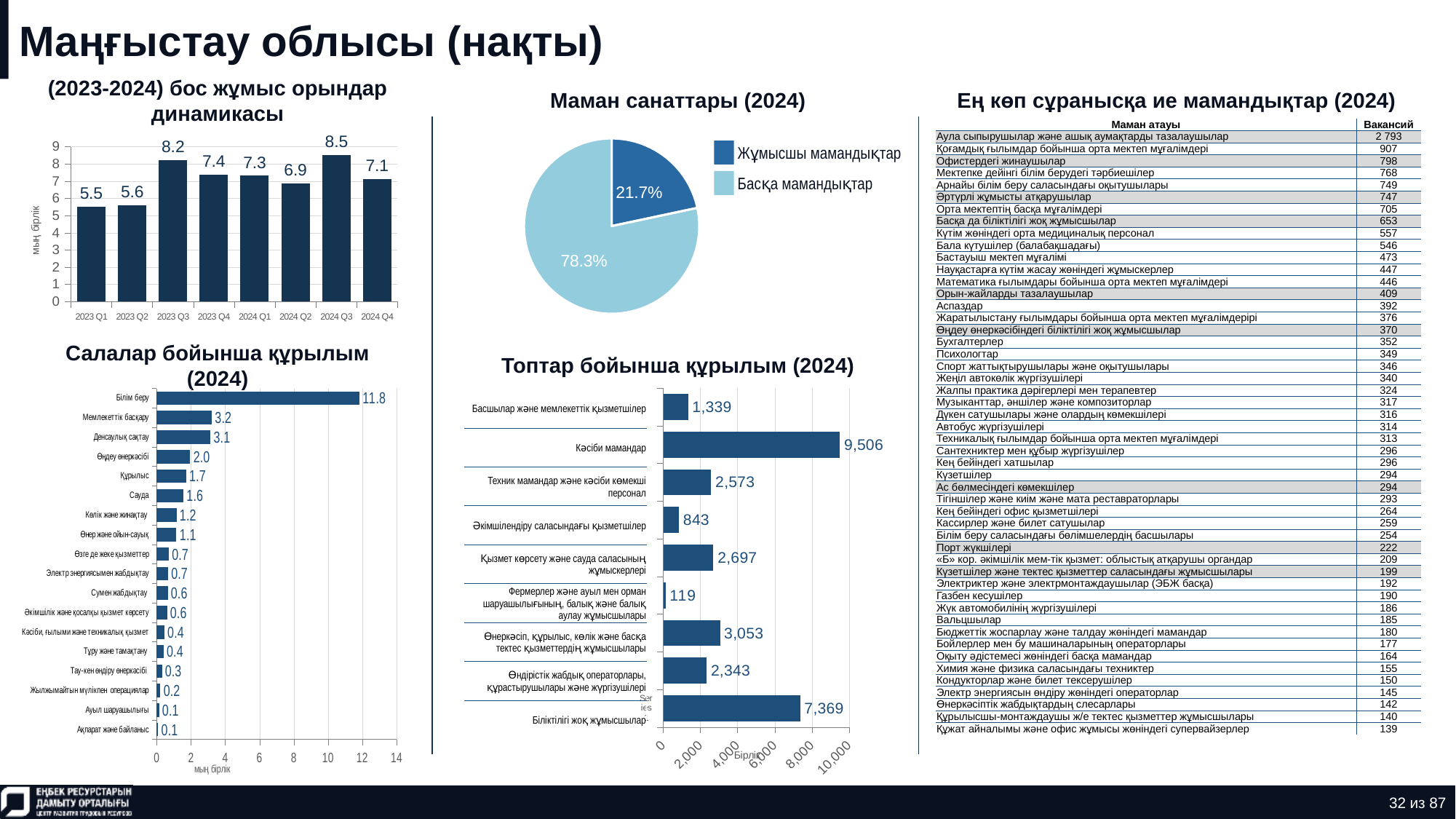
In the chart 'Топтар бойынша құрылым (2024)', which group has the highest value? Кәсіби мамандар In the chart '(2023-2024) бос жұмыс орындар динамикасы', which quarter has the lowest value? 2023 Q1 In the chart '(2023-2024) бос жұмыс орындар динамикасы', how many quarters are plotted? 8 In the chart 'Салалар бойынша құрылым (2024)', how many categories are shown? 18 In the pie chart 'Маман санаттары (2024)', how many entries does the legend list? 2 In the chart 'Топтар бойынша құрылым (2024)', what is the difference between 'Кәсіби мамандар' and 'Біліктілігі жоқ жұмысшылар'? 2,137 What type of chart is 'Топтар бойынша құрылым (2024)'? Bar chart In the chart 'Салалар бойынша құрылым (2024)', what is the value for 'Білім беру'? 11.8 In the chart '(2023-2024) бос жұмыс орындар динамикасы', what is the difference between 2023 Q3 and 2023 Q4? 0.8 In the chart 'Салалар бойынша құрылым (2024)', which is larger: 'Мемлекеттік басқару' or 'Өңдеу өнеркәсібі'? Мемлекеттік басқару In the chart '(2023-2024) бос жұмыс орындар динамикасы', what is the value for 2024 Q3? 8.5 In the pie chart 'Маман санаттары (2024)', what share is 'Жұмысшы мамандықтар'? 21.7%